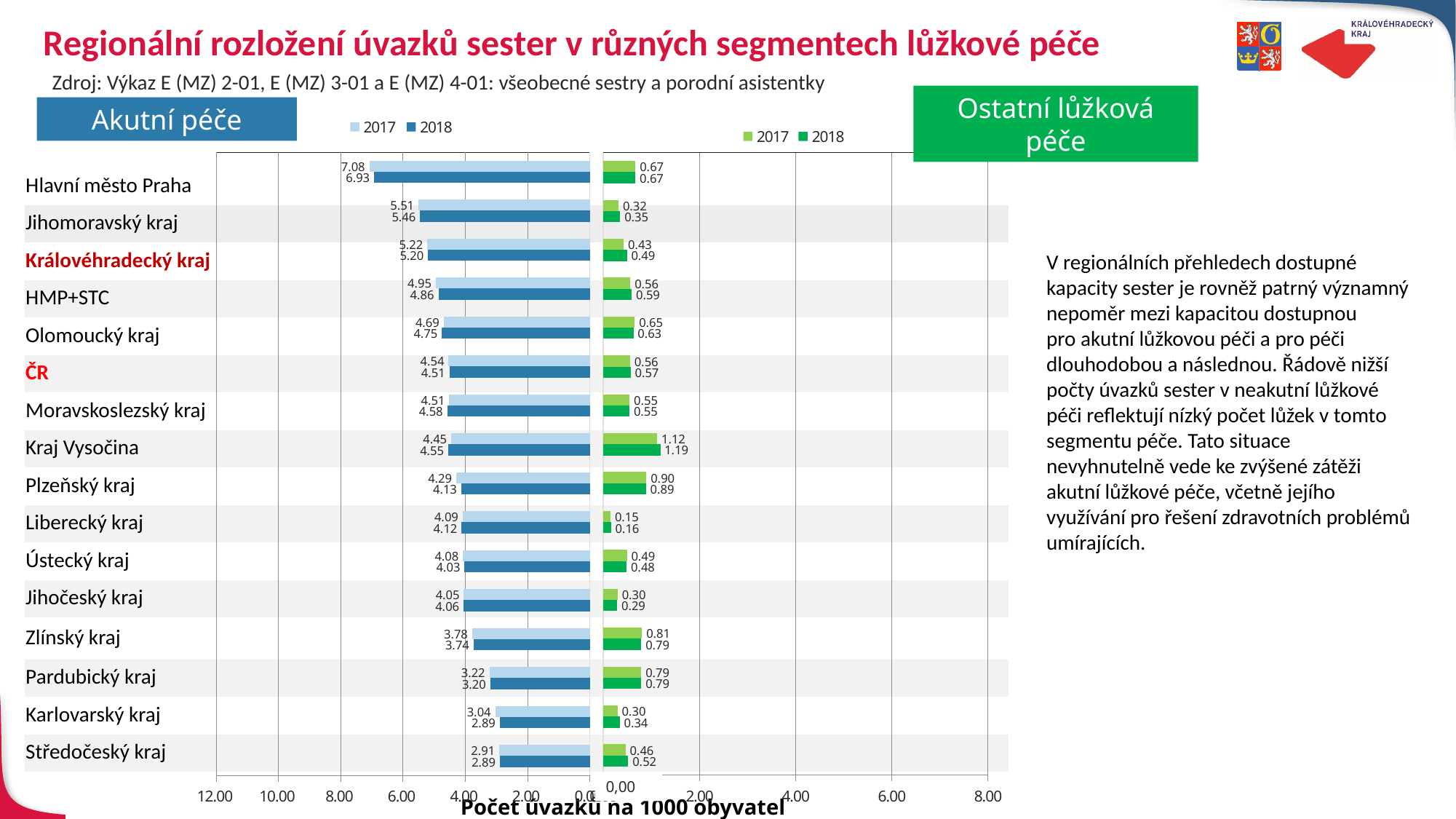
In the Ostatní lůžková péče chart, what is the 2018 value for Liberecký kraj? 0.16 In the Akutní péče chart, which region has the highest 2018 value? Hlavní město Praha How many regions (categories) are listed in the Akutní péče chart? 16 What type of chart is the Akutní péče chart? Bar chart How many series does the legend of the Ostatní lůžková péče chart list? 2 In the Akutní péče chart, what is the 2017 value for Královéhradecký kraj? 5.22 In the Ostatní lůžková péče chart, which is larger for Zlínský kraj: the 2017 value or the 2018 value? 2017 In the Ostatní lůžková péče chart, which region has the lowest 2017 value? Liberecký kraj In the Akutní péče chart, what is the 2018 value for Hlavní město Praha? 6.93 In the Ostatní lůžková péče chart, what is the 2017 value for Kraj Vysočina? 1.12 In the Akutní péče chart, is the 2018 value for Jihomoravský kraj greater or less than 4.00? greater In the Akutní péče chart, what is the difference between the 2017 and 2018 values for Hlavní město Praha? 0.15